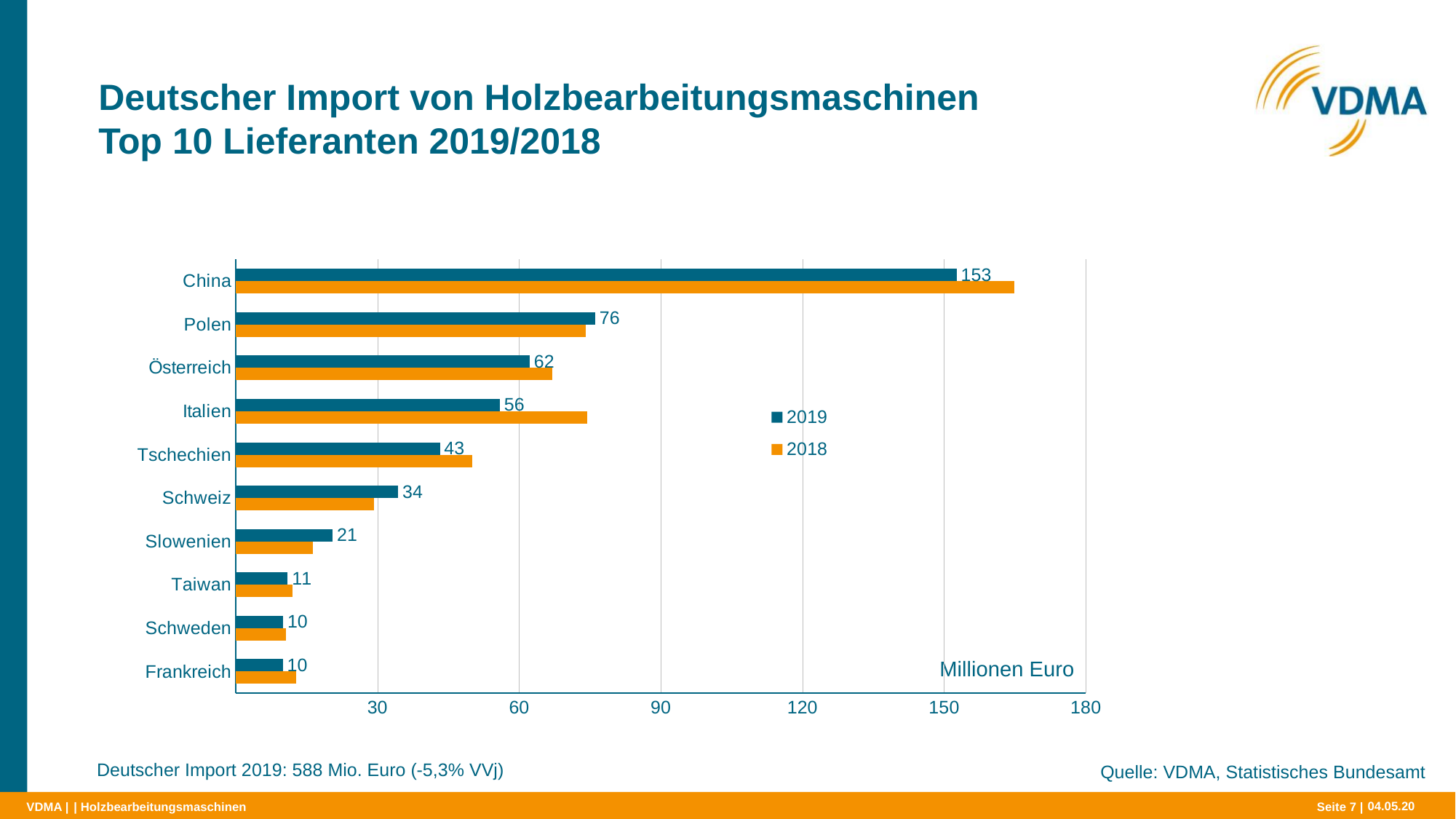
How many series does the legend list? 2 Which is larger for China: the 2019 value or the 2018 value? 2018 Is the 2018 value for Italien greater or less than 60? greater Which country has the highest 2019 value? China What kind of chart is shown on the slide? Bar chart What is the difference between the 2019 values for Polen and Österreich? 14 What was the value for Italien in 2019? 56 Is the 2018 value for China greater or less than 150? greater What was the value for China in 2019? 153 What was the value for Tschechien in 2019? 43 How many countries are shown in the chart? 10 Which is larger: the 2019 value for Schweiz or the 2019 value for Slowenien? Schweiz